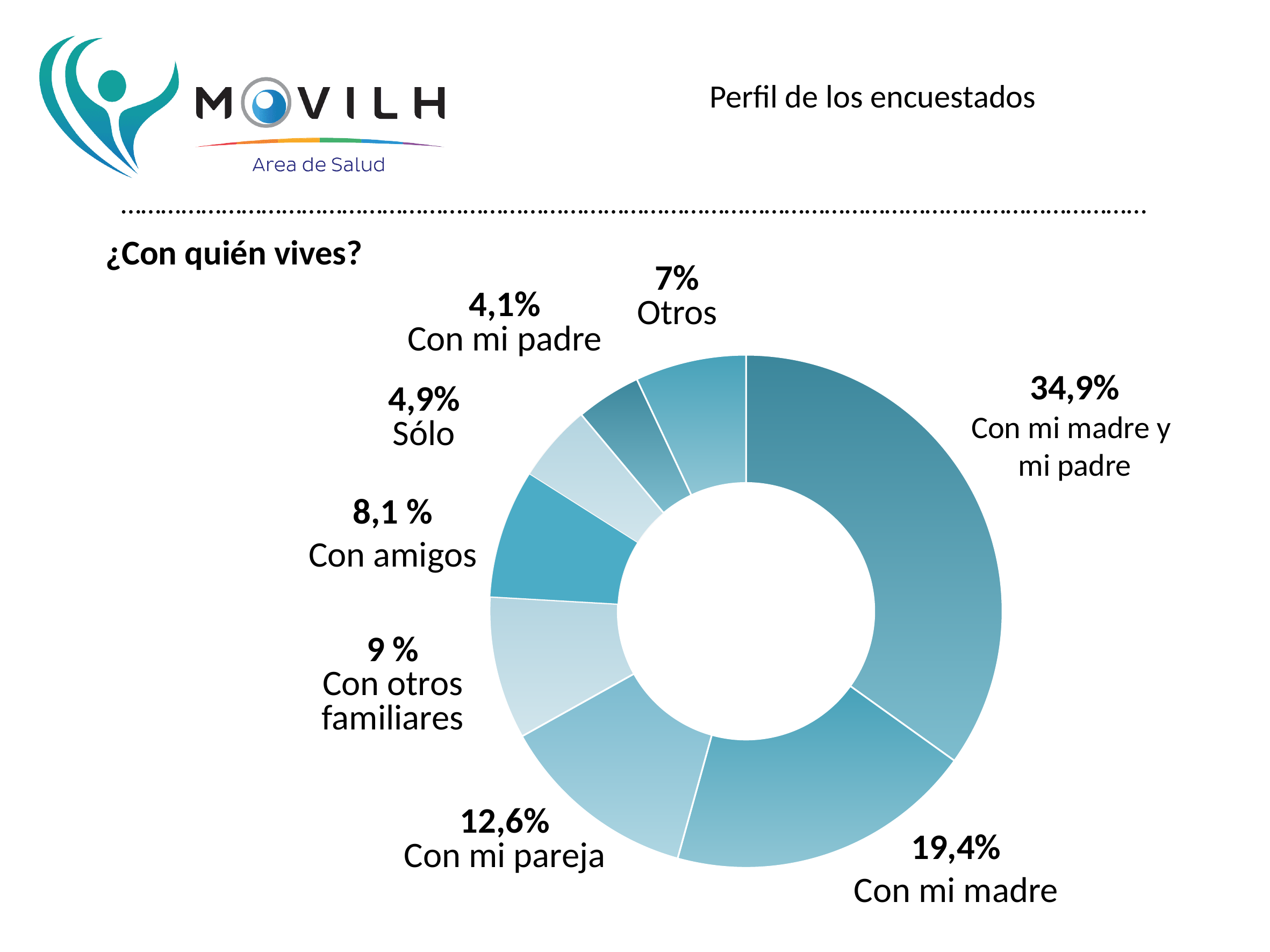
Which is larger: the share for 'Con otros familiares' or the share for 'Con amigos'? Con otros familiares What question does the chart answer, according to the heading above it? ¿Con quién vives? What percentage of respondents live alone (Sólo)? 4,9% What is the combined share of 'Con mi madre' and 'Con mi padre'? 23,5% What percentage of respondents live with their partner (Con mi pareja)? 12,6% What is the difference in percentage points between 'Con mi madre y mi padre' and 'Con mi madre'? 15,5 What percentage of respondents live with friends (Con amigos)? 8,1 % How many categories are shown in the chart? 8 What percentage of respondents live with their mother and father (Con mi madre y mi padre)? 34,9% Which category has the largest share of the chart? Con mi madre y mi padre What kind of chart is shown on the slide? Doughnut (pie) chart Which category has the smallest share of the chart? Con mi padre